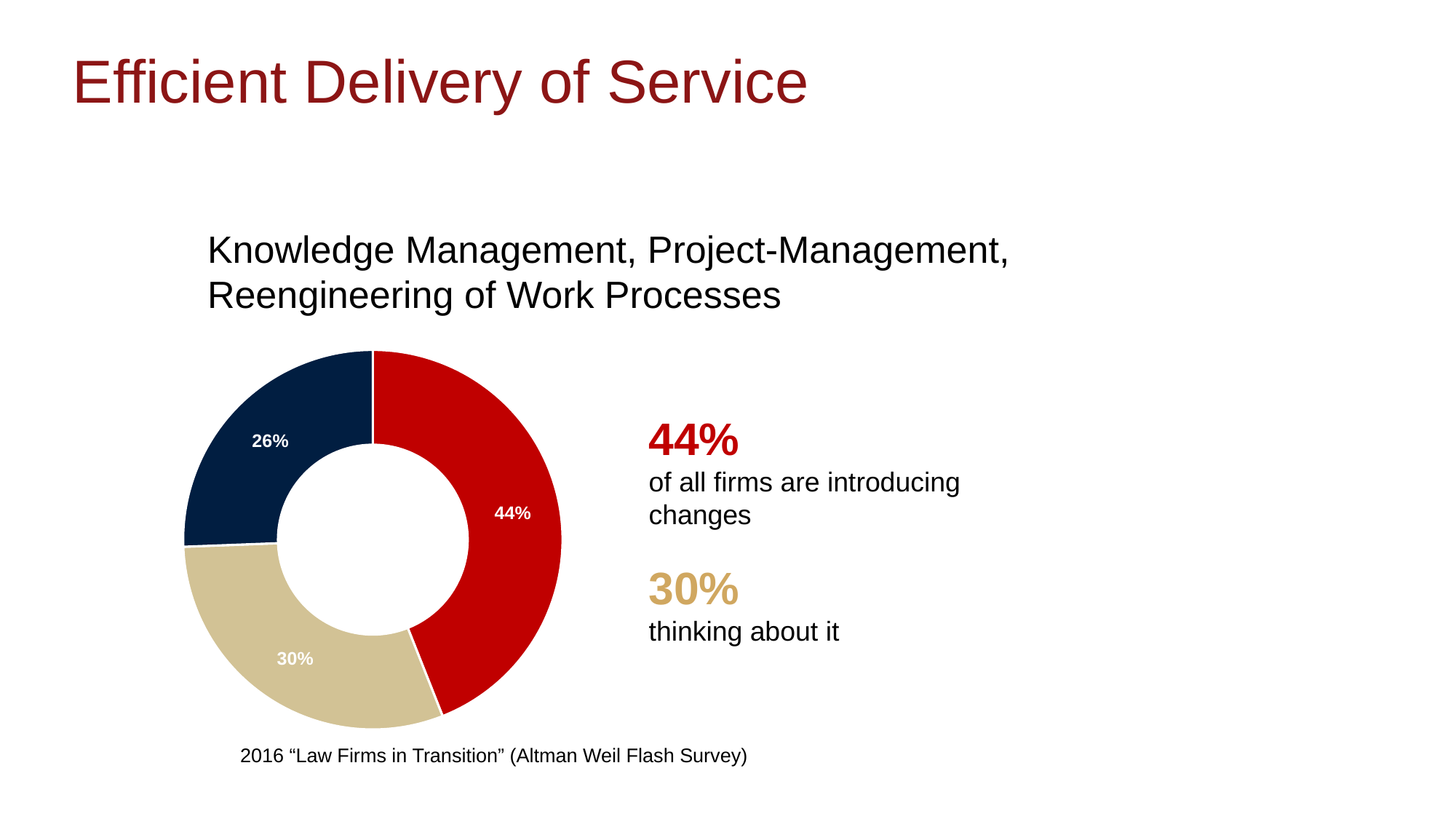
Which is larger: the share of firms thinking about it or the share shown on the dark blue slice? Thinking about it (30%) What is the smallest value shown on the donut chart? 26% Which slice of the donut chart is the largest? 44% (introducing changes) What do the three slices of the donut chart add up to? 100% What source is cited below the chart? 2016 "Law Firms in Transition" (Altman Weil Flash Survey) How many percentage points larger is the share of firms introducing changes than the share thinking about it? 14 percentage points What kind of chart is shown on the slide? Donut (pie) chart What colour is the slice representing firms introducing changes? Red How many slices does the donut chart have? 3 What share of firms are introducing changes according to the donut chart? 44% What percentage of firms are thinking about it, as shown on the chart? 30% What value is printed on the dark blue slice of the donut chart? 26%